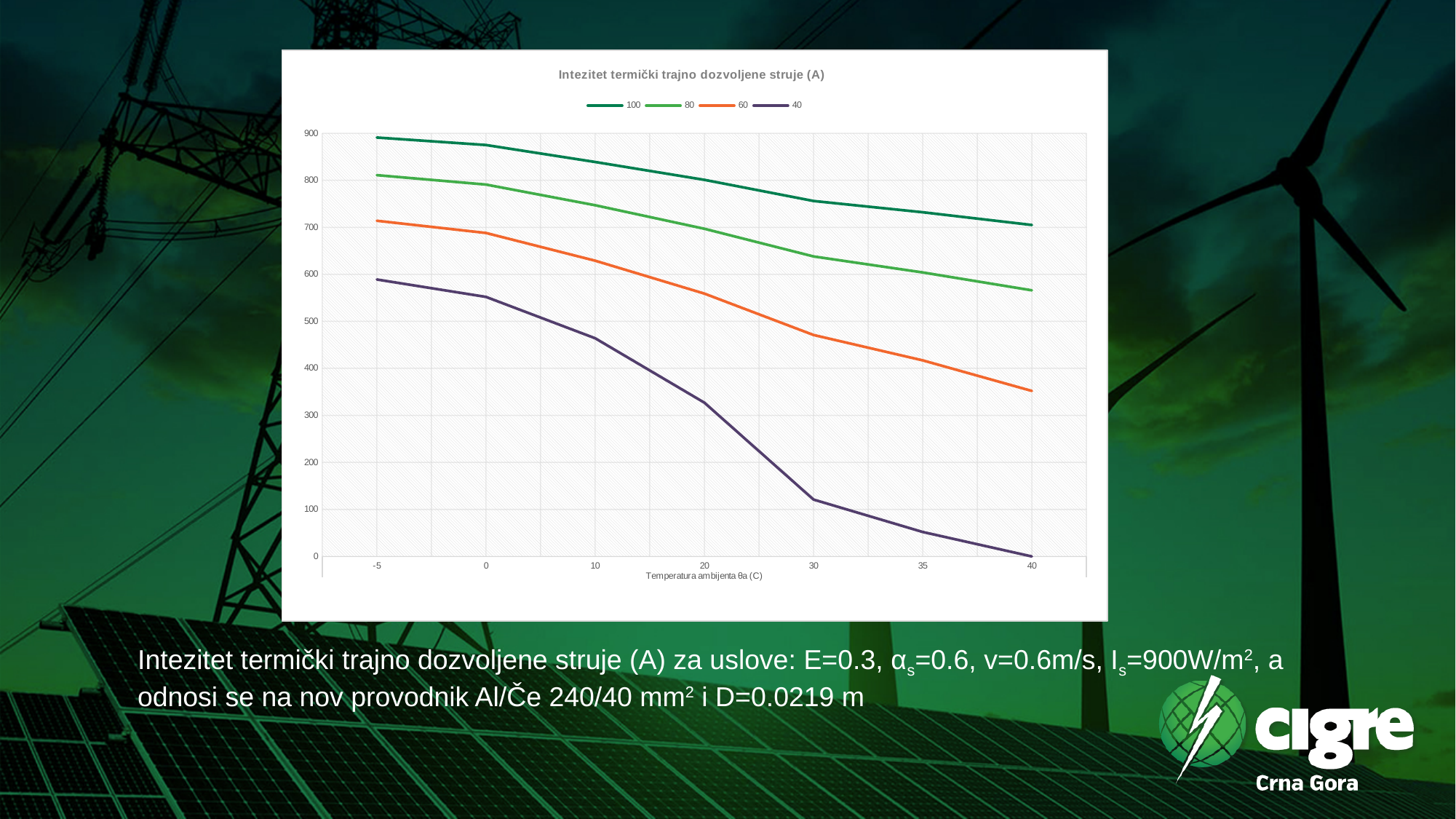
How many temperature points are plotted along the x axis? 7 Is the value of series 100 at a temperature of -5 greater or less than 800? greater Is the value of series 60 at a temperature of 40 greater or less than 400? less Which series has the lowest value at a temperature of 20? 40 Is the value of series 40 at a temperature of 30 greater or less than 200? less Which series has the highest value at a temperature of 40? 100 What is the label of the x axis? Temperatura ambijenta θa (C) At a temperature of 20, which series has the larger value, 100 or 40? 100 How many series does the legend list? 4 Do the values of the series 100 rise or fall as the temperature increases along the x axis? fall What kind of chart is shown on the slide? line chart What is the title of the chart? Intezitet termički trajno dozvoljene struje (A)